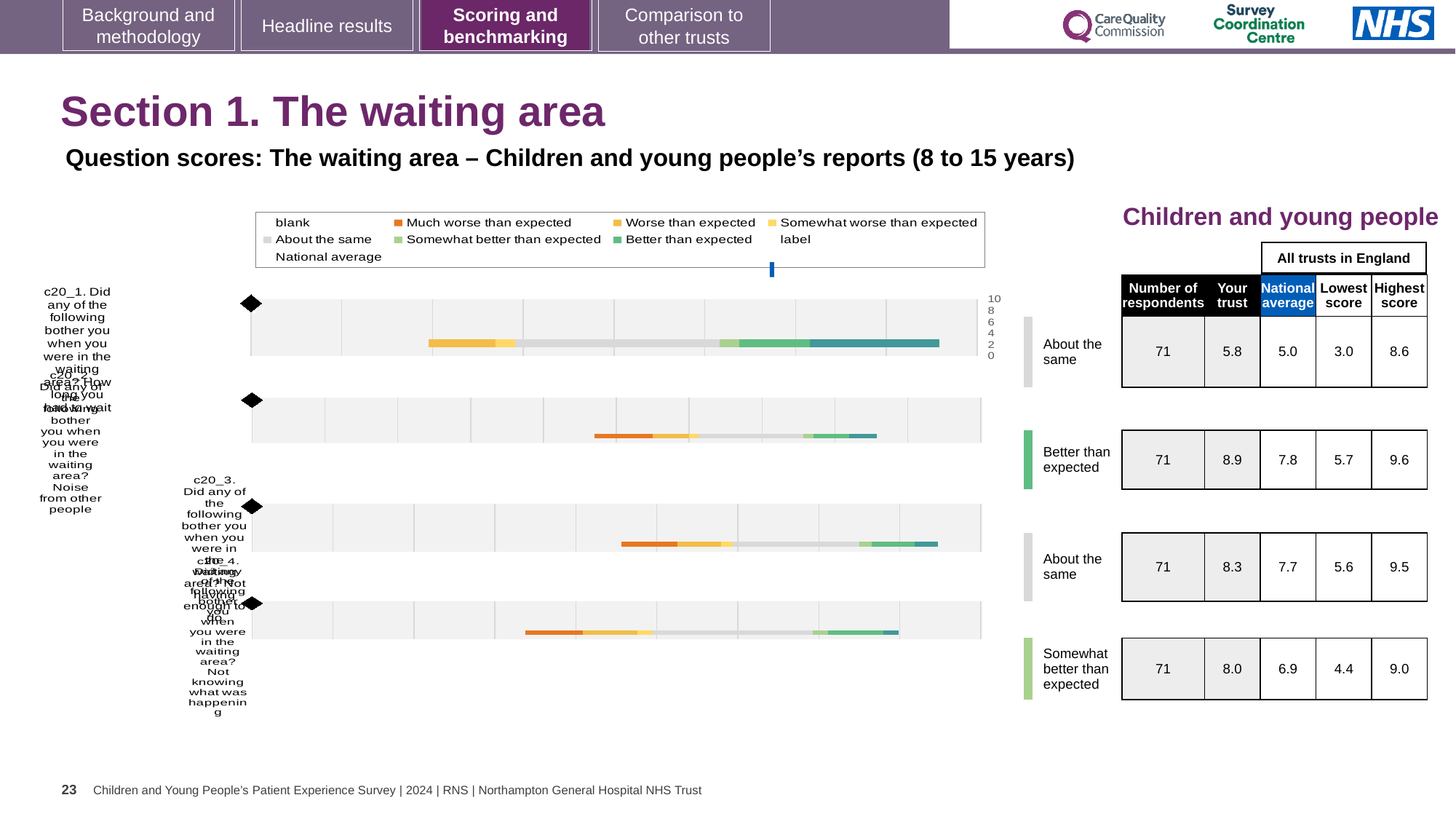
How many entries does the chart legend list? 9 How many question bars (c20_1 to c20_4) are plotted on the slide? 4 What is the lowest score shown for the fourth bar (c20_4)? 4.4 Which of the four question bars has the highest 'Your trust' score in the table? c20_2 According to the table beside the second bar (c20_2), what is the 'Your trust' score? 8.9 What colour does the legend use for 'Much worse than expected'? orange For the second bar (c20_2), which is larger: the 'Your trust' score or the national average? Your trust What is the national average shown for the third bar (c20_3)? 7.7 According to the table beside the first bar (c20_1), what is the 'Your trust' score? 5.8 For the second bar (c20_2), what is the difference between the 'Your trust' score (8.9) and the national average (7.8)? 1.1 What kind of chart is used to show the question scores on this slide? bar chart What is the maximum value shown on the score axis of the bar charts? 10